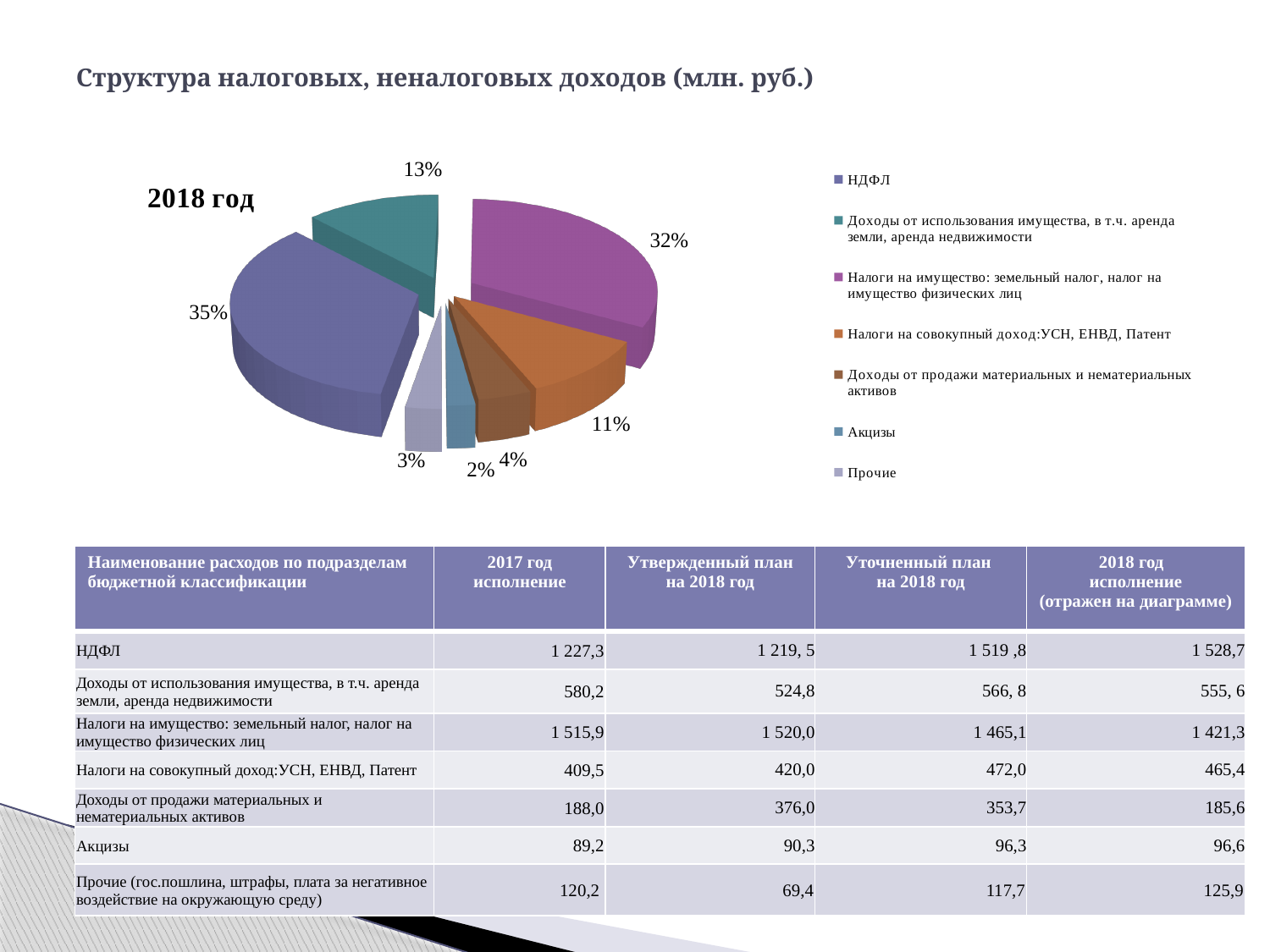
What share of the pie chart does Налоги на совокупный доход:УСН, ЕНВД, Патент have? 11% What share of the pie chart does Доходы от использования имущества, в т.ч. аренда земли, аренда недвижимости have? 13% How many entries does the legend of the pie chart list? 7 What share of the pie chart does НДФЛ have? 35% Which category has the smallest slice in the pie chart? Акцизы Which year does the pie chart represent, according to the label next to it? 2018 год What is the difference in percentage points between the НДФЛ slice and the Налоги на имущество slice? 3 Which category has the largest slice in the pie chart? НДФЛ How many slices does the pie chart have? 7 What kind of chart is shown on the slide? pie chart